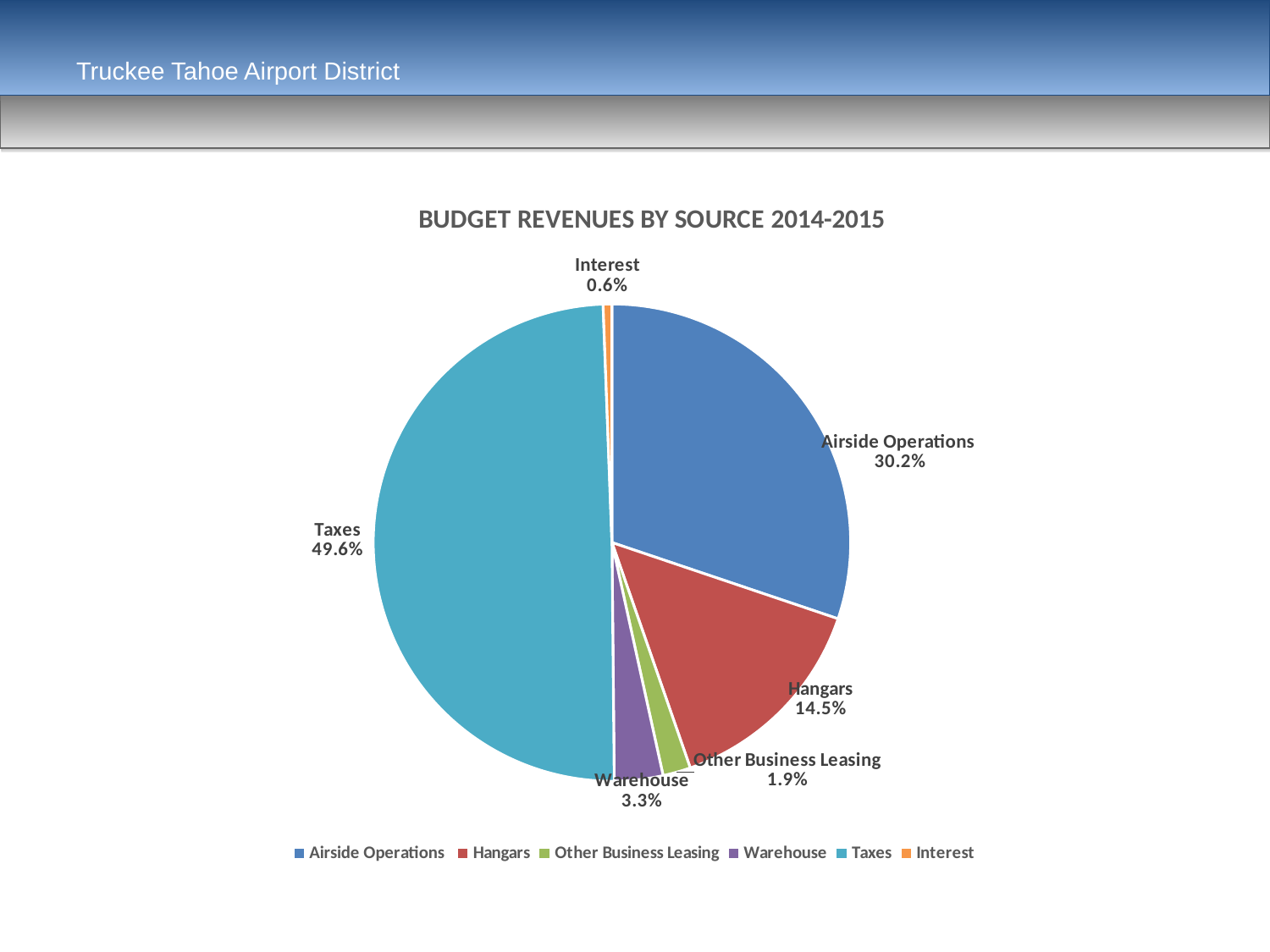
What is the title of the chart? BUDGET REVENUES BY SOURCE 2014-2015 What share of budget revenues comes from Warehouse? 3.3% What share of budget revenues comes from Interest? 0.6% What share of budget revenues comes from Hangars? 14.5% How many revenue sources are shown in the pie chart? 6 What kind of chart is shown on the slide? Pie chart Which revenue source has the smallest share of the pie? Interest Which revenue source has the largest share of the pie? Taxes What share of budget revenues comes from Taxes? 49.6% Which has a larger share, Hangars or Other Business Leasing? Hangars What share of budget revenues comes from Airside Operations? 30.2% What is the difference in percentage points between the Taxes share and the Airside Operations share? 19.4